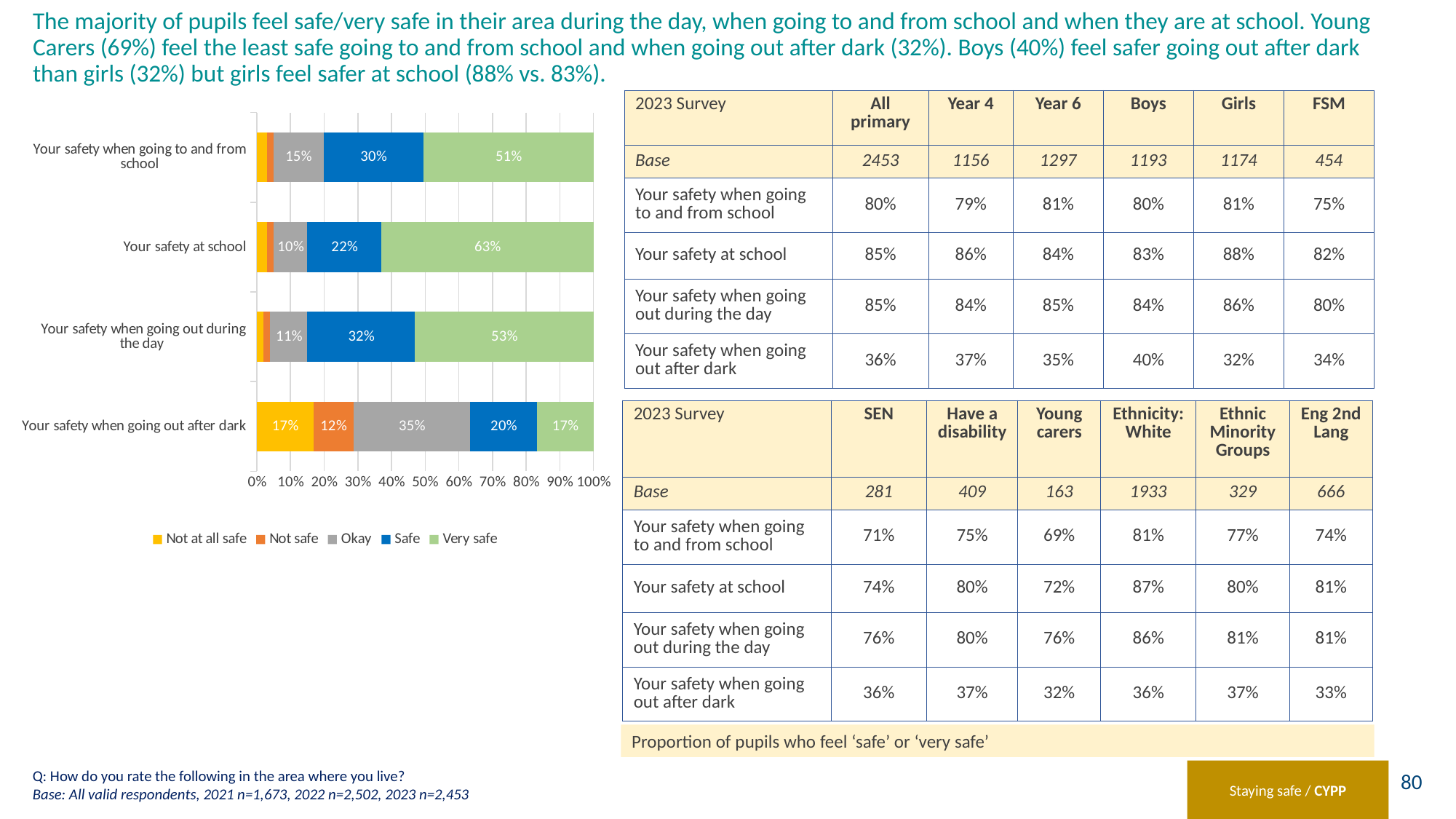
In the bar chart, what percentage of pupils rated 'Your safety when going out after dark' as Okay? 35% What kind of chart is shown on the left of the slide? Stacked bar chart In the bar chart, what is the Safe value for 'Your safety when going out during the day'? 32% How many series does the bar chart's legend list? 5 What colour represents the Very safe series in the bar chart? Green Which category in the bar chart has the lowest Very safe percentage? Your safety when going out after dark In the bar chart, what is the Not at all safe value for 'Your safety when going out after dark'? 17% Which category in the bar chart has the highest Very safe percentage? Your safety at school In the bar chart, what percentage of pupils rated 'Your safety at school' as Very safe? 63% How many safety categories are plotted in the bar chart? 4 In the bar chart, which has the larger Safe value: 'Your safety when going to and from school' or 'Your safety when going out during the day'? Your safety when going out during the day In the bar chart, what is the difference between the Very safe value for 'Your safety at school' and for 'Your safety when going out after dark'? 46 percentage points